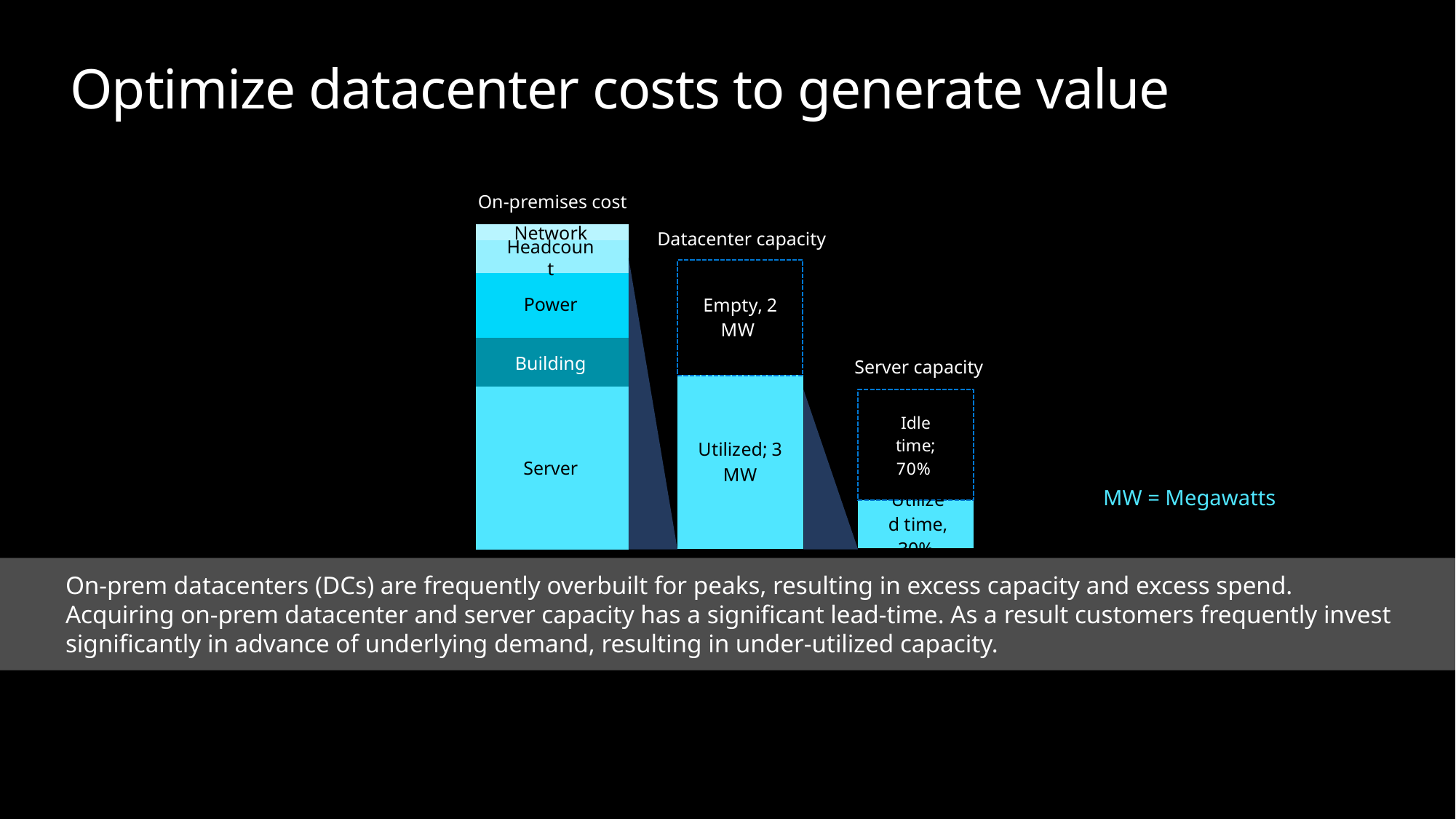
In the Datacenter capacity chart, what is the difference between the Utilized and Empty segments? 1 MW In the Datacenter capacity chart, what is the total capacity of the stacked bar (Empty plus Utilized)? 5 MW In the Server capacity chart, which segment is larger, Idle time or Utilized time? Idle time In the On-premises cost chart, which segment is the smallest? Network In the On-premises cost chart, which segment is the largest? Server According to the note on the slide, what does MW stand for? Megawatts In the Server capacity chart, what percentage is shown for Idle time? 70% In the Datacenter capacity chart, what is the value of the Empty segment? 2 MW What kind of chart is the On-premises cost chart? Stacked bar chart In the Datacenter capacity chart, which segment is larger, Empty or Utilized? Utilized In the Datacenter capacity chart, what is the value of the Utilized segment? 3 MW How many segments make up the On-premises cost stacked bar? 5